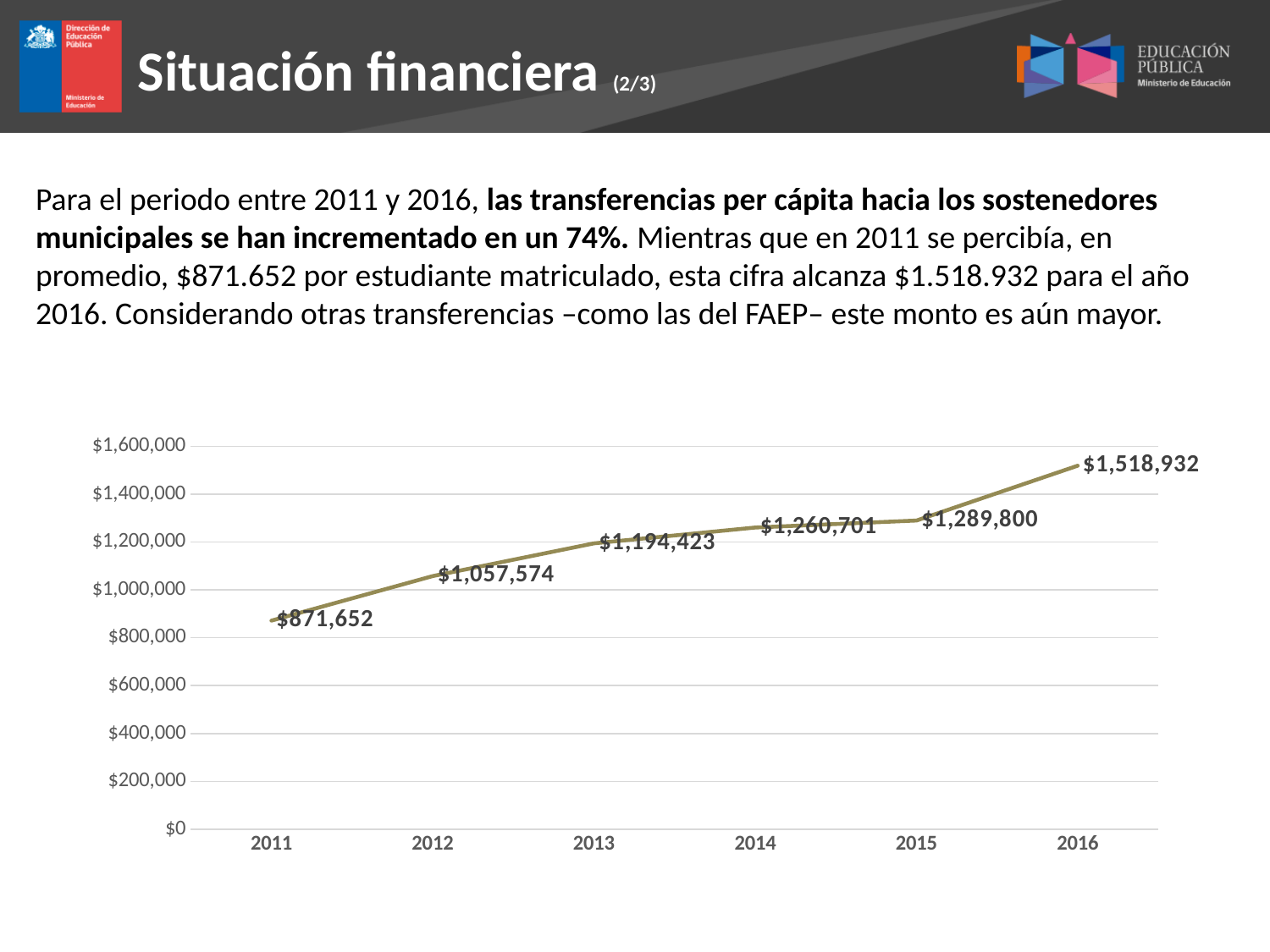
Which year has the highest value? 2016 What type of chart is shown on the slide? line chart What is the value plotted for 2015? $1,289,800 What is the difference between the values for 2012 and 2011? $185,922 Which year has the lowest value? 2011 What is the value plotted for 2013? $1,194,423 Which is larger, the value for 2014 or the value for 2012? 2014 What is the value plotted for 2011? $871,652 Do the values rise or fall from 2011 to 2016? rise What is the value plotted for 2016? $1,518,932 What is the difference between the values for 2016 and 2011? $647,280 How many years are plotted on the x axis? 6